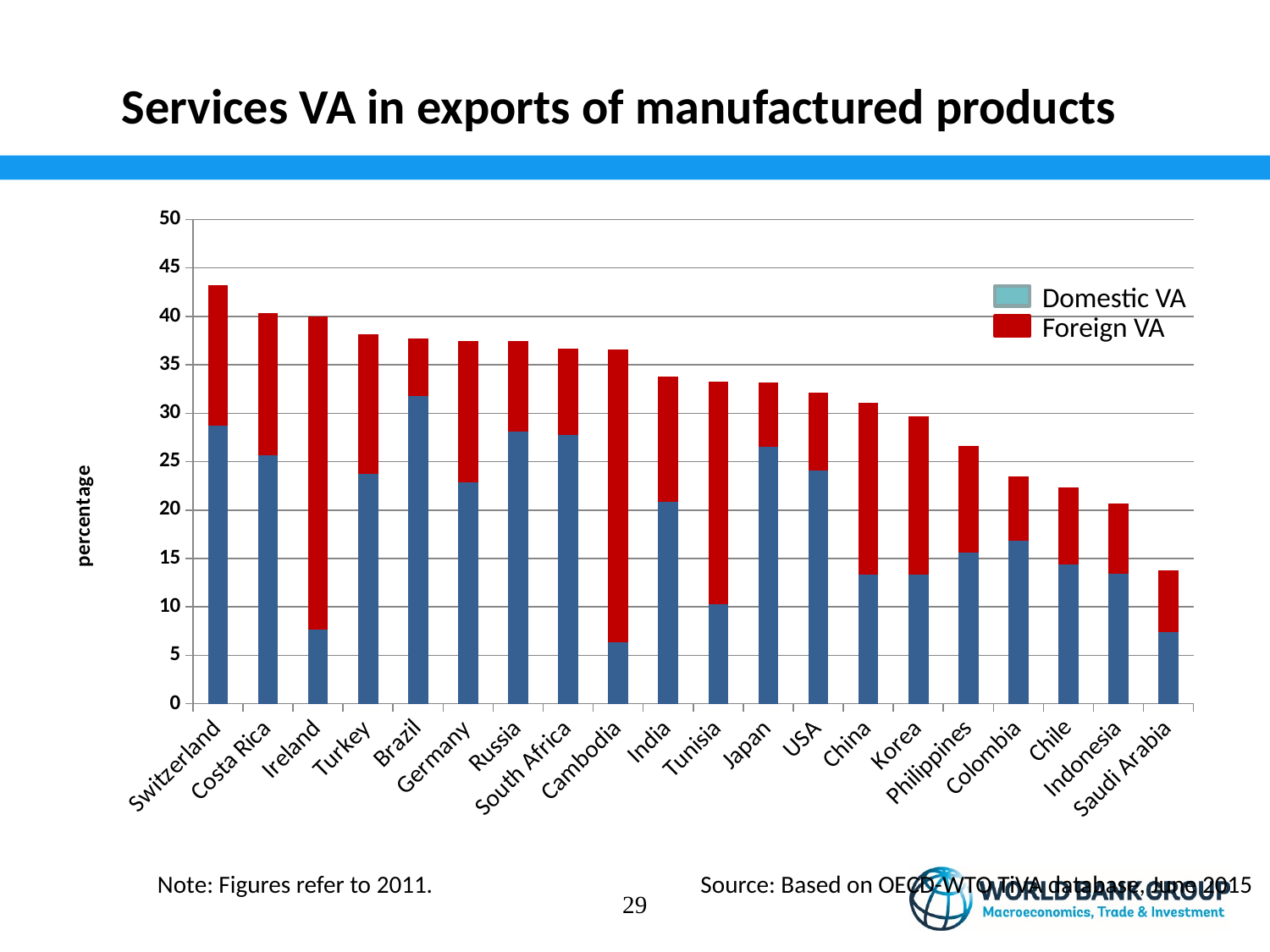
How many countries are shown on the x axis of the chart? 20 Do the total bar heights rise or fall moving from left to right along the x axis? fall Which country has the lowest total services VA in exports of manufactured products? Saudi Arabia What kind of chart is shown on the slide? Stacked bar chart Is the Domestic VA value for Cambodia greater or less than 10? less Which country has the largest Domestic VA share? Brazil Which country has the highest total services VA in exports of manufactured products? Switzerland Which is larger, the Foreign VA for Ireland or the Foreign VA for Turkey? Ireland How many series does the chart's legend list? 2 What is the label on the y axis of the chart? percentage Is the total value for Saudi Arabia greater or less than 20? less Is the total value for Switzerland greater or less than 40? greater